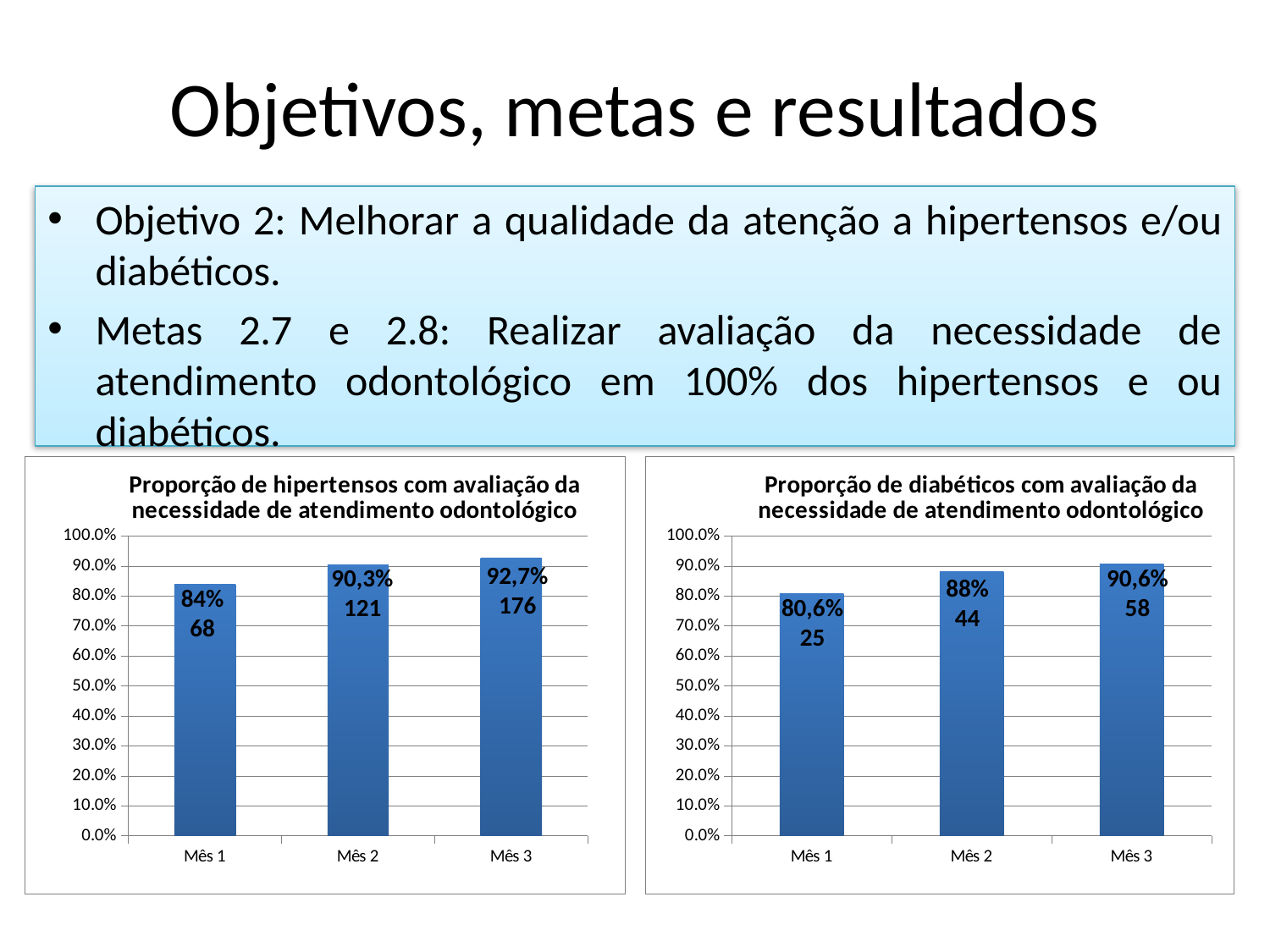
In the chart 'Proporção de diabéticos com avaliação da necessidade de atendimento odontológico', which month has the lowest value? Mês 1 In the chart 'Proporção de hipertensos com avaliação da necessidade de atendimento odontológico', what count is labelled on the bar for Mês 3? 176 In the chart 'Proporção de diabéticos com avaliação da necessidade de atendimento odontológico', do the values rise or fall from Mês 1 to Mês 3? Rise What kind of chart is 'Proporção de hipertensos com avaliação da necessidade de atendimento odontológico'? Bar chart In the chart 'Proporção de hipertensos com avaliação da necessidade de atendimento odontológico', what percentage is shown for Mês 1? 84% In the chart 'Proporção de hipertensos com avaliação da necessidade de atendimento odontológico', what is the difference in count between Mês 3 and Mês 2? 55 In the chart 'Proporção de diabéticos com avaliação da necessidade de atendimento odontológico', which is larger, the value for Mês 1 or Mês 3? Mês 3 How many bars are shown in the chart 'Proporção de diabéticos com avaliação da necessidade de atendimento odontológico'? 3 In the chart 'Proporção de hipertensos com avaliação da necessidade de atendimento odontológico', which month has the highest value? Mês 3 In the chart 'Proporção de diabéticos com avaliação da necessidade de atendimento odontológico', what count is labelled on the bar for Mês 1? 25 In the chart 'Proporção de diabéticos com avaliação da necessidade de atendimento odontológico', what percentage is shown for Mês 2? 88% In the chart 'Proporção de hipertensos com avaliação da necessidade de atendimento odontológico', is the value for Mês 1 greater or less than 90.0%? less